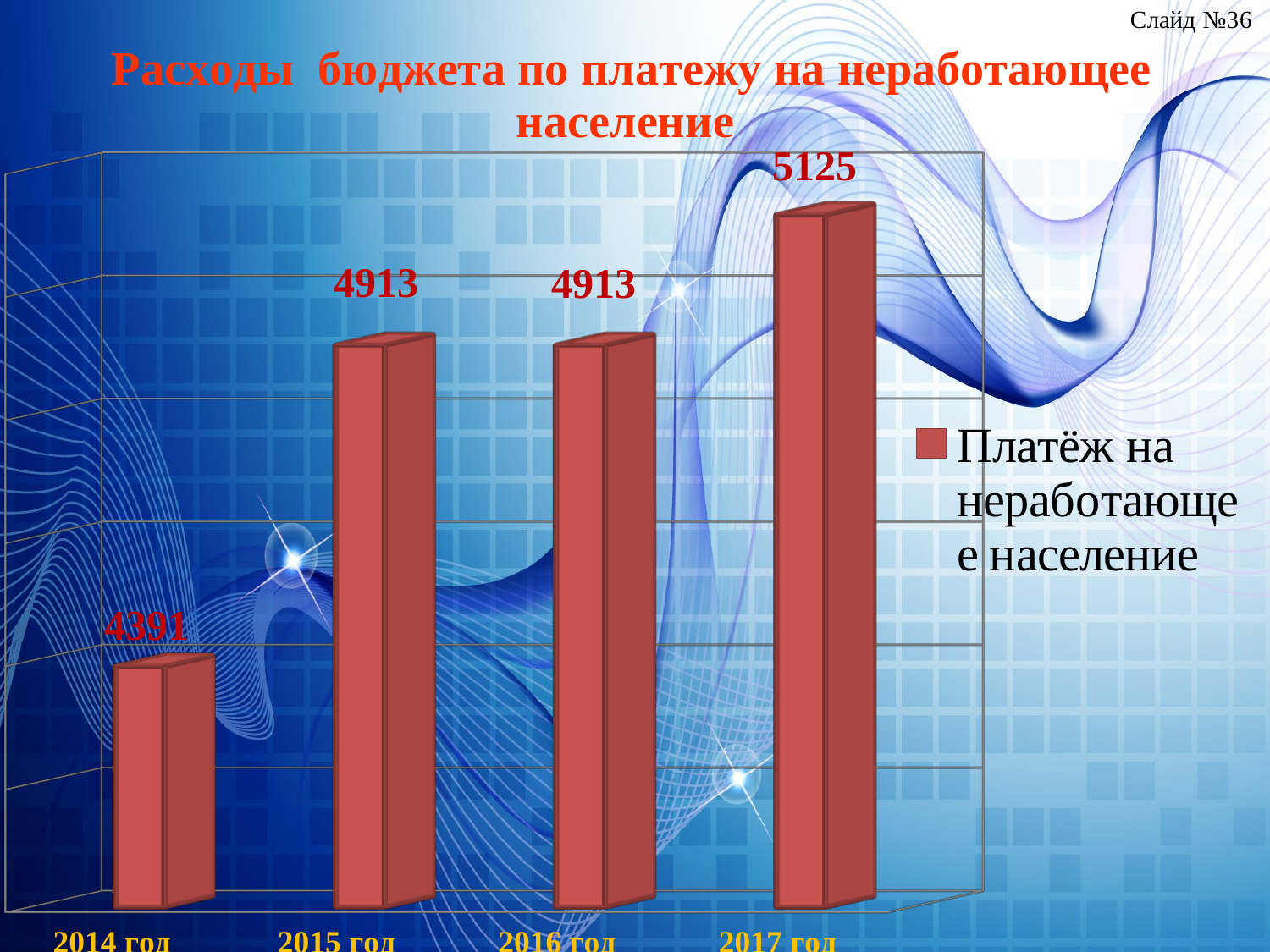
What is the difference between the values for 2015 год and 2014 год? 522 Which is larger, the value for 2017 год or the value for 2016 год? 2017 год How many years are shown on the chart? 4 What is the value for 2014 год? 4391 What is the legend entry for the series shown? Платёж на неработающее население Which year has the highest value? 2017 год What is the value for 2017 год? 5125 Which year has the lowest value? 2014 год What is the difference between the values for 2017 год and 2014 год? 734 How many series does the legend list? 1 What is the value for 2015 год? 4913 What kind of chart is shown on the slide? bar chart